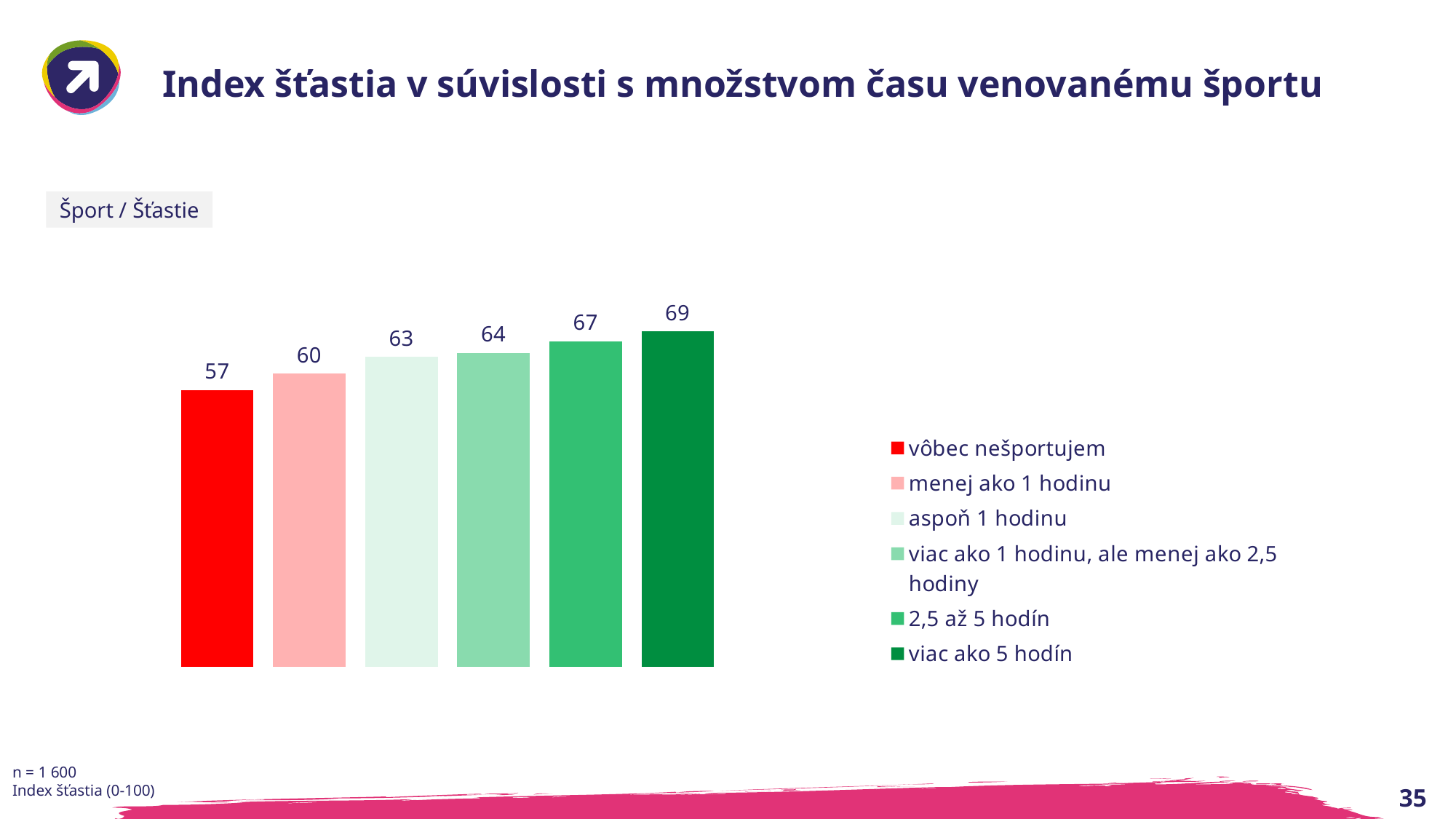
How many categories are shown in the chart? 6 Do the values rise or fall from left to right across the bars? rise Which category has the highest happiness index? viac ako 5 hodín Which has a higher happiness index: "menej ako 1 hodinu" or "2,5 až 5 hodín"? 2,5 až 5 hodín What is the happiness index value for "menej ako 1 hodinu"? 60 Which category has the lowest happiness index? vôbec nešportujem What is the happiness index value for "aspoň 1 hodinu"? 63 What is the happiness index value for "viac ako 1 hodinu, ale menej ako 2,5 hodiny"? 64 What is the difference between the happiness index for "viac ako 5 hodín" and "vôbec nešportujem"? 12 What is the happiness index value for "viac ako 5 hodín"? 69 What is the happiness index value for "2,5 až 5 hodín"? 67 What is the happiness index value for "vôbec nešportujem"? 57